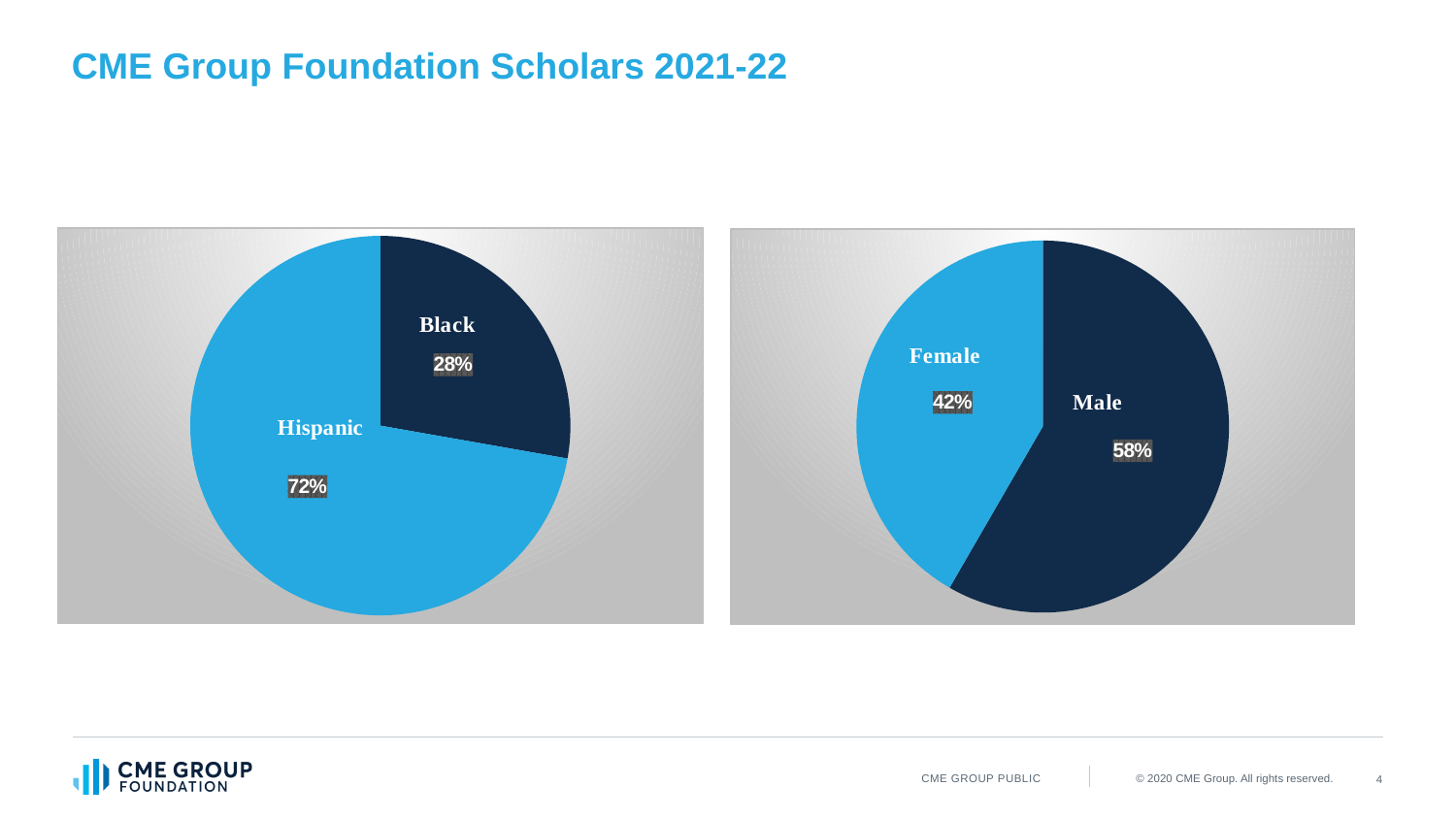
In the left pie chart, what is the difference in percentage points between Hispanic and Black? 44 In the right pie chart, which category has the smallest share? Female In the right pie chart, what percentage of scholars are Male? 58% How many slices does the left pie chart have? 2 In the right pie chart, what percentage of scholars are Female? 42% In the left pie chart, what percentage of scholars are Black? 28% What type of chart is the right chart on the slide? Pie chart What is the title of the slide containing the two pie charts? CME Group Foundation Scholars 2021-22 In the left pie chart, which category has the largest share? Hispanic In the left pie chart, what percentage of scholars are Hispanic? 72% In the right pie chart, what is the difference in percentage points between Male and Female? 16 In the right pie chart, which is larger, Male or Female? Male